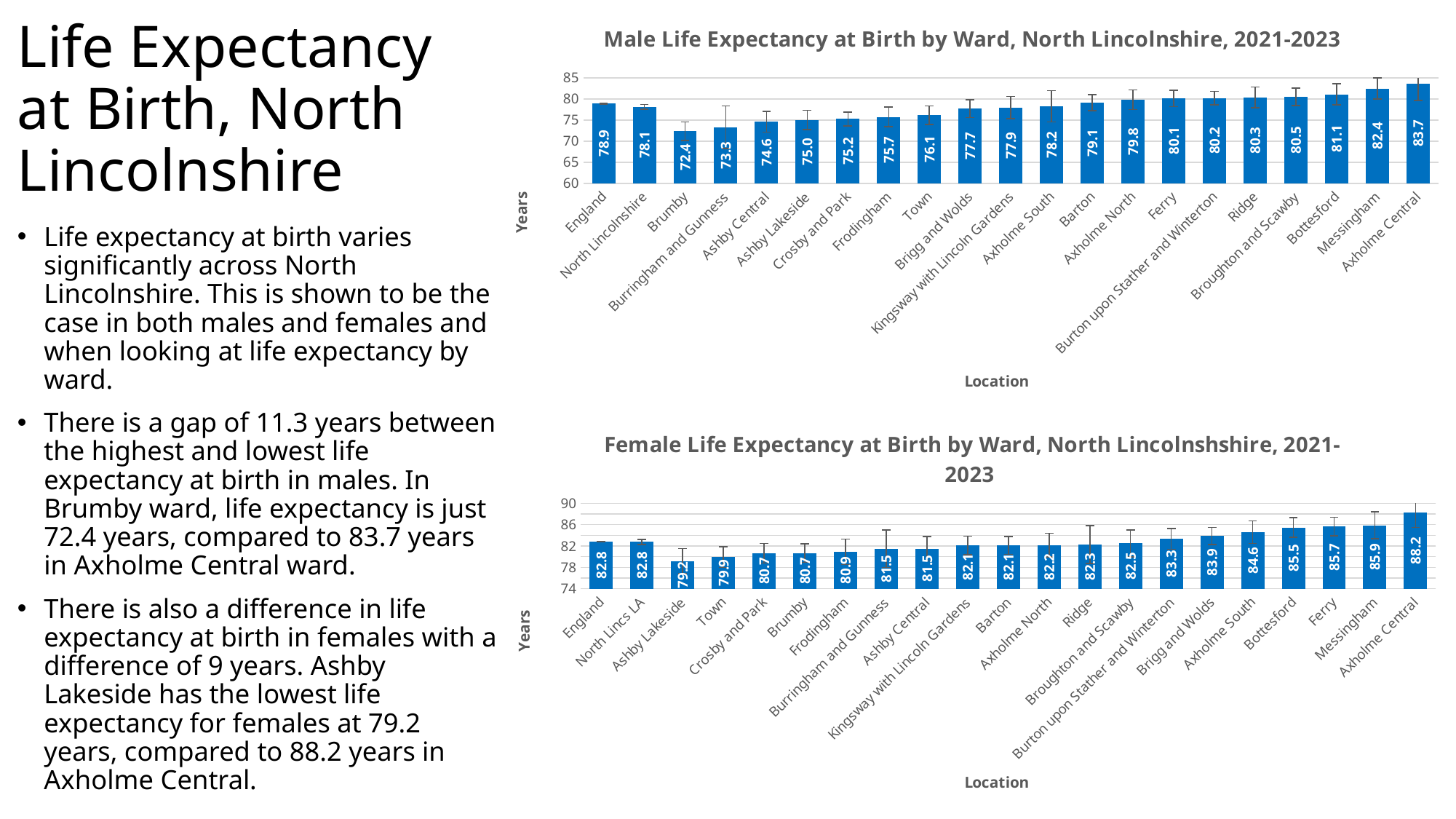
In the Female Life Expectancy chart, what is the difference between Axholme Central and Ashby Lakeside? 9 In the Female Life Expectancy chart, which ward has the lowest value? Ashby Lakeside In the Male Life Expectancy chart, what is the value for Brumby? 72.4 In the Male Life Expectancy chart, which ward has the highest value? Axholme Central In the Male Life Expectancy chart, how many bars are plotted? 21 In the Female Life Expectancy chart, what is the value for Axholme Central? 88.2 In the Male Life Expectancy chart, what is the value for Messingham? 82.4 In the Female Life Expectancy chart, what is the value for England? 82.8 In the Male Life Expectancy chart, what is the difference between Axholme Central and Brumby? 11.3 What kind of chart is the Male Life Expectancy chart? Bar chart In the Female Life Expectancy chart, which is larger, the value for Ferry or the value for Town? Ferry What is the label on the vertical axis of the Female Life Expectancy chart? Years